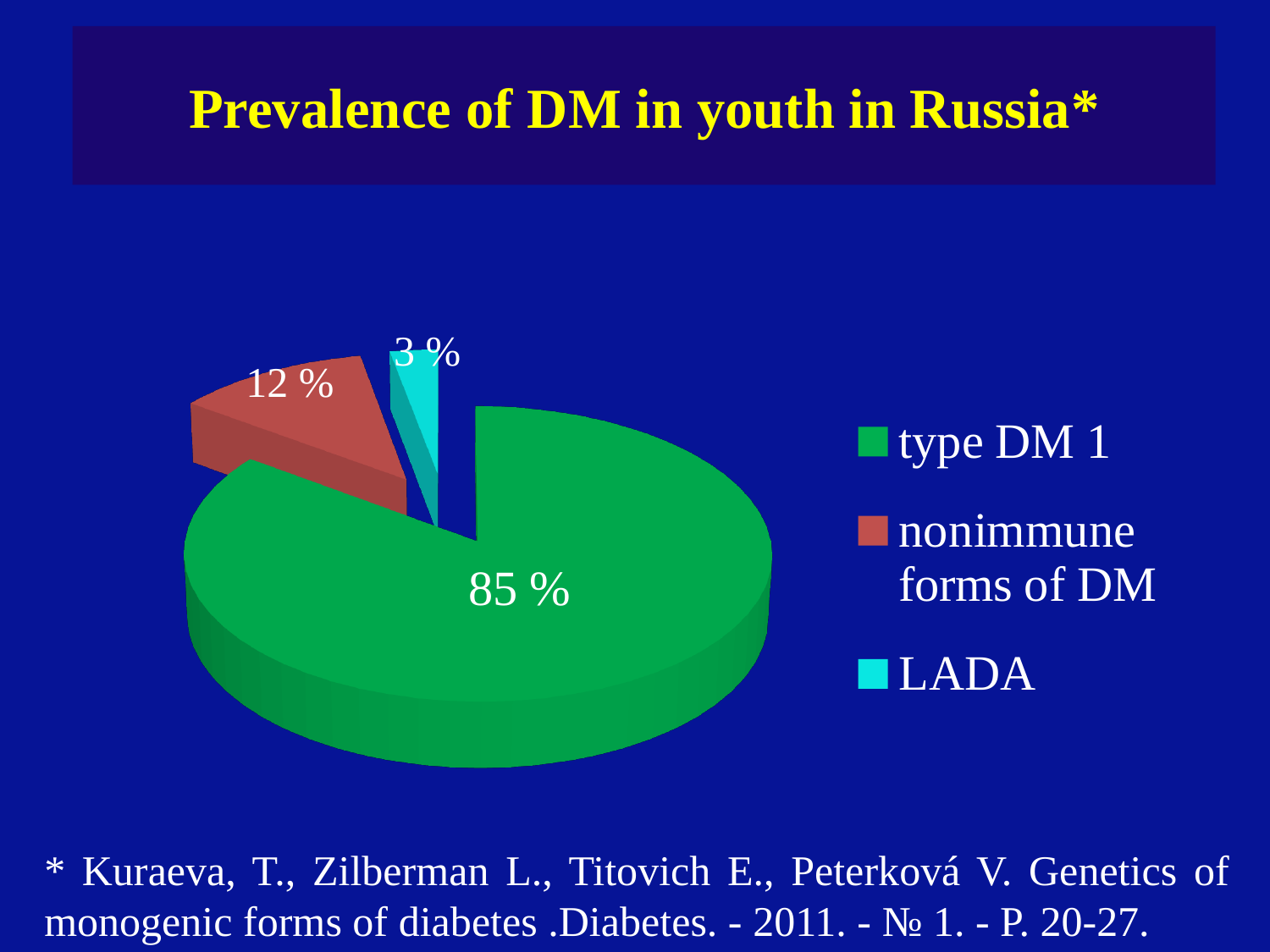
What kind of chart is shown on the slide? pie chart Which is larger, the share for nonimmune forms of DM or the share for LADA? nonimmune forms of DM What share of the pie does LADA represent? 3 % What is the difference in percentage points between type DM 1 and nonimmune forms of DM? 73 What share of the pie does type DM 1 represent? 85 % What is the title of the chart? Prevalence of DM in youth in Russia* How many categories does the pie chart show? 3 What is the difference in percentage points between nonimmune forms of DM and LADA? 9 What colour is the slice for LADA? cyan Which category has the smallest slice of the pie? LADA Which category has the largest slice of the pie? type DM 1 What share of the pie do nonimmune forms of DM represent? 12 %